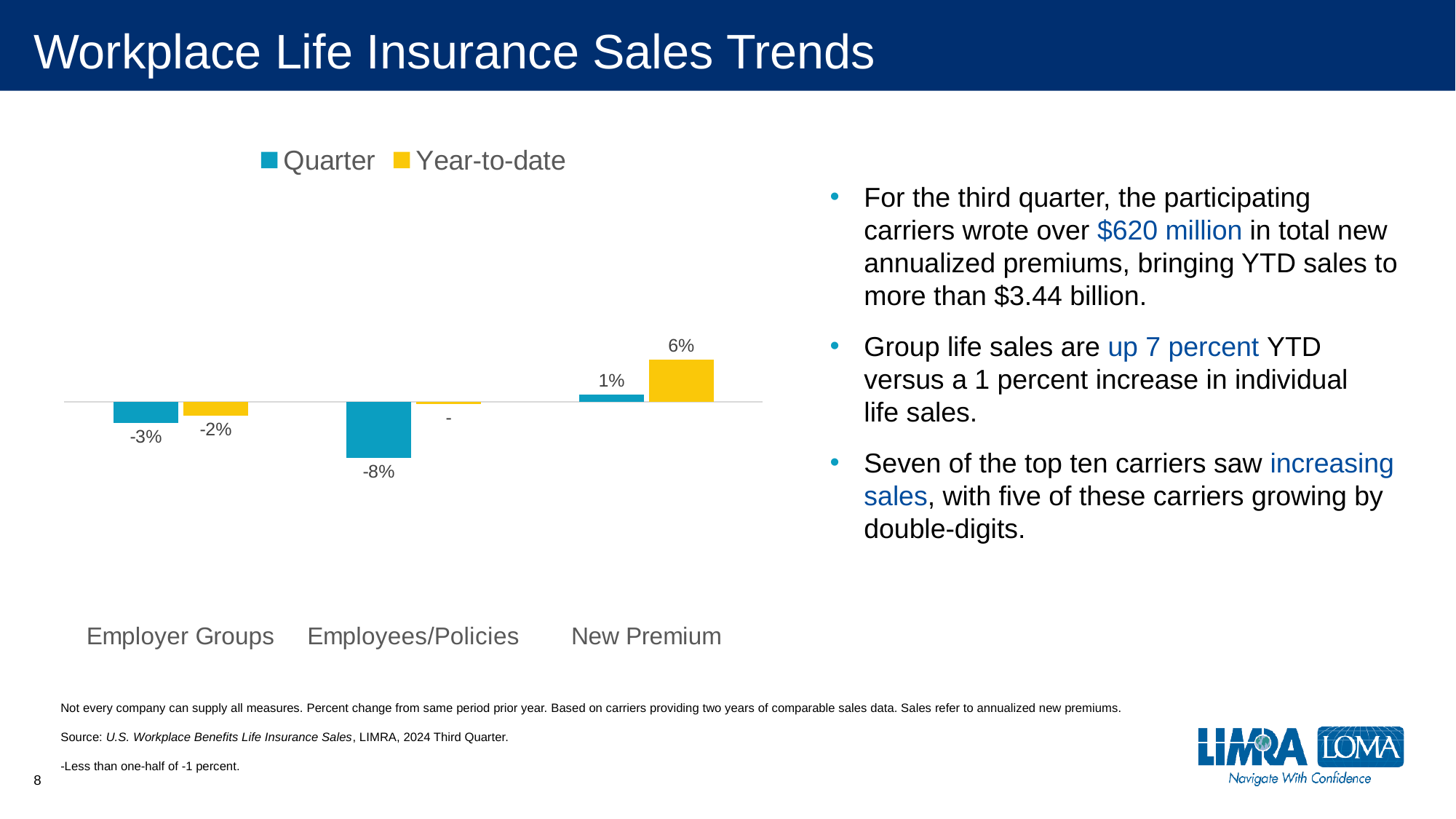
Which category has the lowest Quarter value? Employees/Policies What is the Quarter value for New Premium? 1% What is the Quarter value for Employer Groups? -3% How many categories are shown on the x axis of the chart? 3 What is the Year-to-date value for New Premium? 6% What is the difference between the Year-to-date and Quarter values for New Premium? 5% Which category has the highest Year-to-date value? New Premium What is the Year-to-date value for Employer Groups? -2% How many series does the chart legend list? 2 What kind of chart is shown on the slide? bar chart Which series is shown in yellow in the chart legend? Year-to-date What is the Quarter value for Employees/Policies? -8%